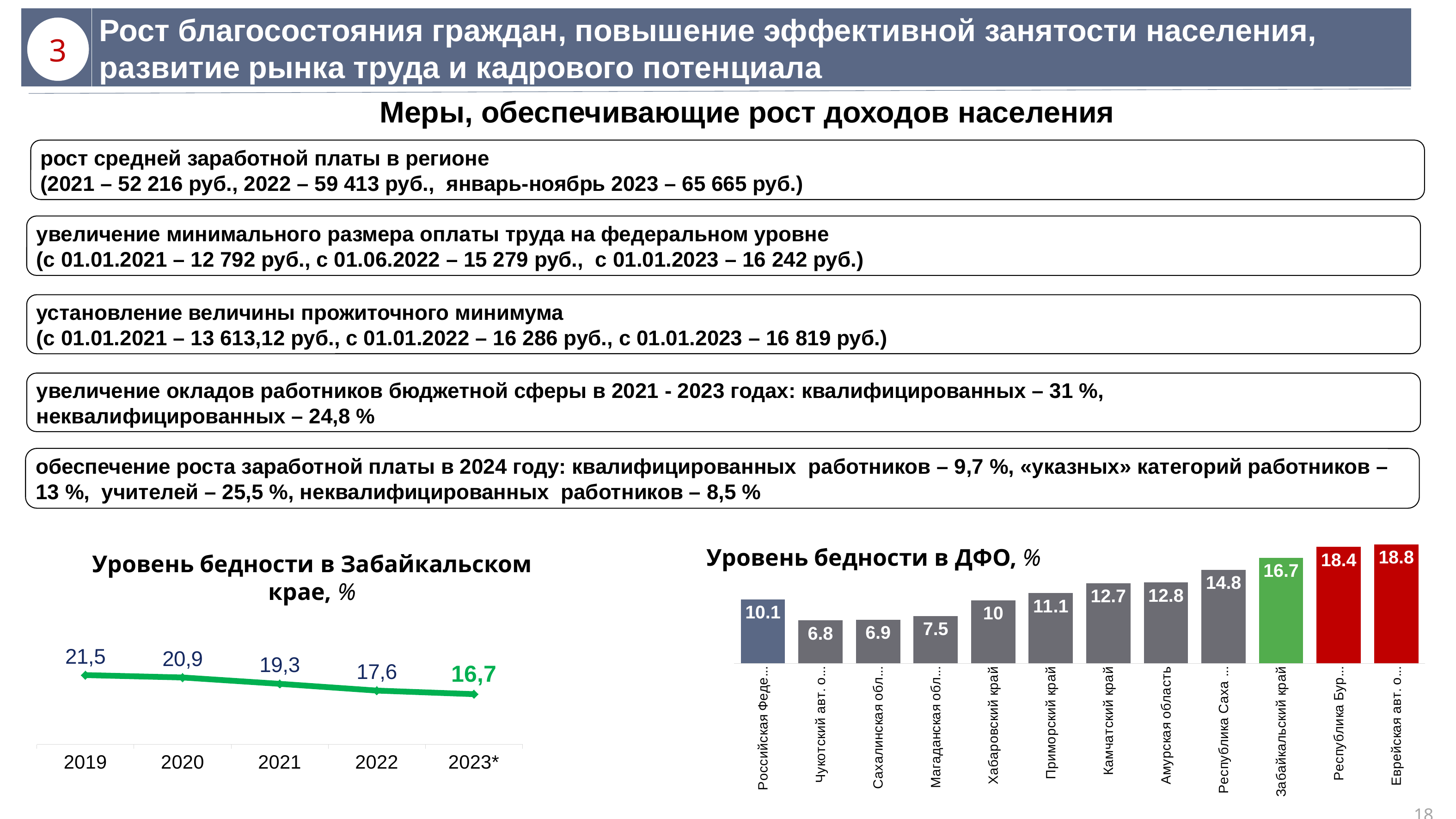
On the chart 'Уровень бедности в Забайкальском крае, %', how many years are plotted? 5 On the chart 'Уровень бедности в ДФО, %', which is larger: Камчатский край or Хабаровский край? Камчатский край What kind of chart is 'Уровень бедности в Забайкальском крае, %'? line chart On the chart 'Уровень бедности в Забайкальском крае, %', what is the difference between the 2019 and 2023* values? 4,8 On the chart 'Уровень бедности в ДФО, %', how many bars are there? 12 On the chart 'Уровень бедности в ДФО, %', what is the value for Забайкальский край? 16.7 On the chart 'Уровень бедности в ДФО, %', what is the lowest value shown? 6.8 On the chart 'Уровень бедности в ДФО, %', what is the highest value shown? 18.8 On the chart 'Уровень бедности в Забайкальском крае, %', do the values rise or fall from 2019 to 2023*? fall On the chart 'Уровень бедности в Забайкальском крае, %', what is the value for 2019? 21,5 On the chart 'Уровень бедности в ДФО, %', what is the value for Приморский край? 11.1 On the chart 'Уровень бедности в Забайкальском крае, %', what is the value for 2023*? 16,7